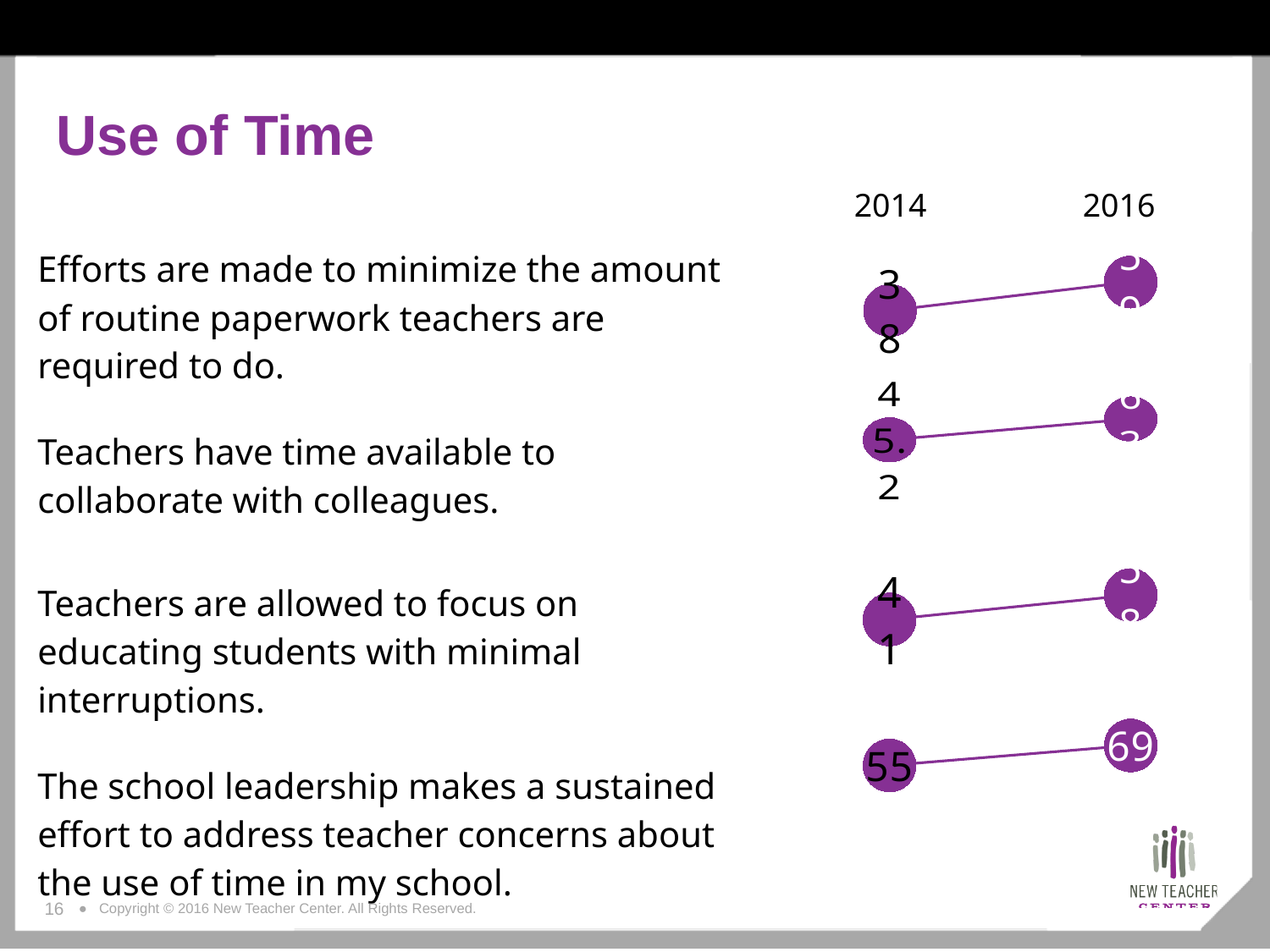
By how much did the value for the school leadership statement change from 2014 to 2016? 14 What is the 2016 value for the statement "The school leadership makes a sustained effort to address teacher concerns about the use of time in my school"? 69 Do the values rise or fall from 2014 to 2016 for the school leadership statement? rise How many statements are plotted in the chart? 4 For the school leadership statement, which year has the larger value, 2014 or 2016? 2016 How many years are compared in the chart? 2 Which two years does the chart compare? 2014 and 2016 What is the 2014 value for the statement "The school leadership makes a sustained effort to address teacher concerns about the use of time in my school"? 55 What colour are the data markers in the chart? purple Do the plotted values rise or fall from 2014 to 2016 across the four statements? rise